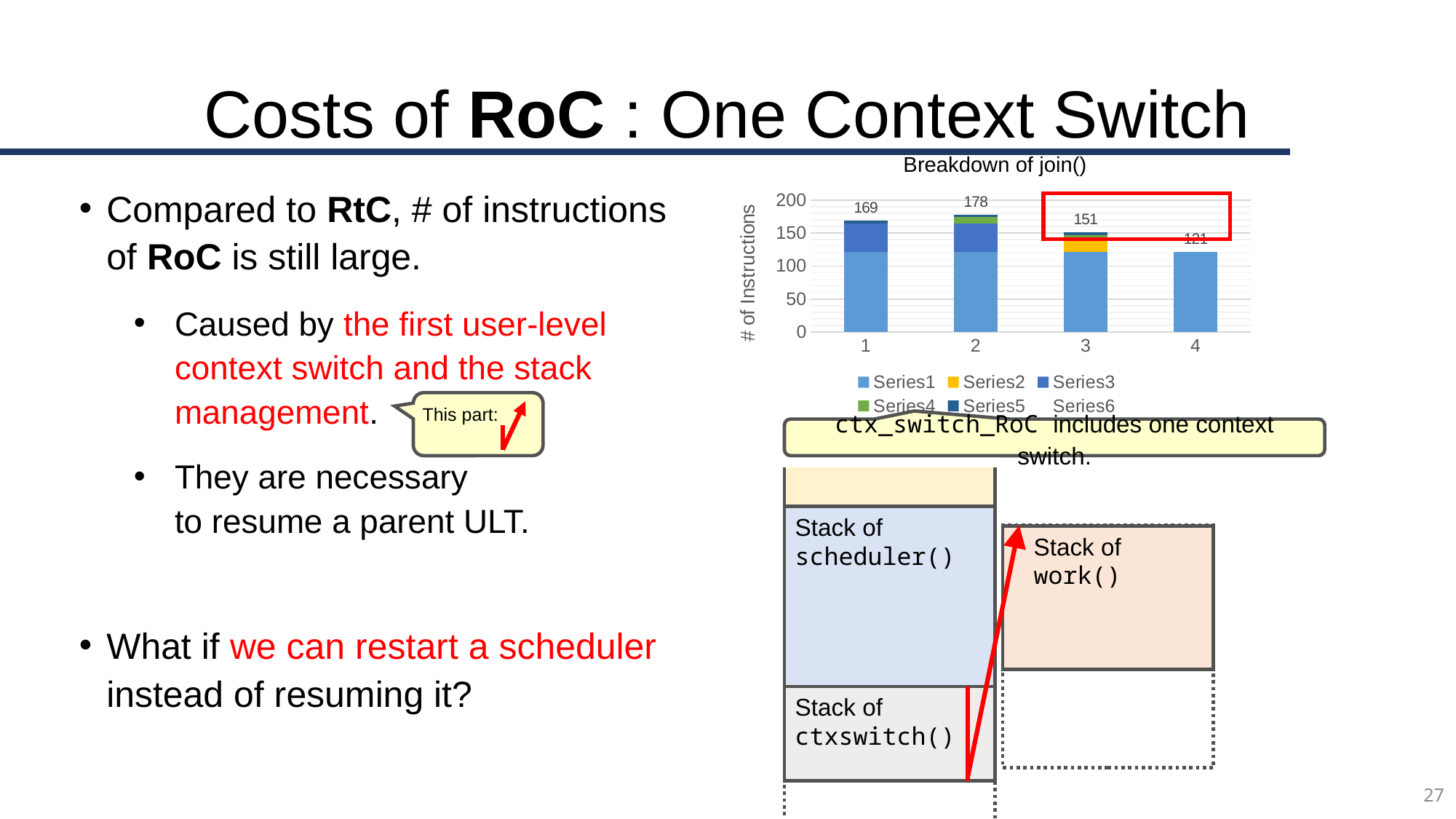
What is the total number of instructions for category 4? 121 What is the difference between the totals for category 2 and category 4? 57 What is the total number of instructions for category 2? 178 What is the title of the chart? Breakdown of join() How many series does the legend list? 6 What is the total number of instructions for category 1? 169 Which category has the lowest total number of instructions? 4 How many categories are shown on the x axis? 4 What kind of chart is shown on the slide? stacked bar chart Which has a larger total, category 1 or category 3? 1 Which category has the highest total number of instructions? 2